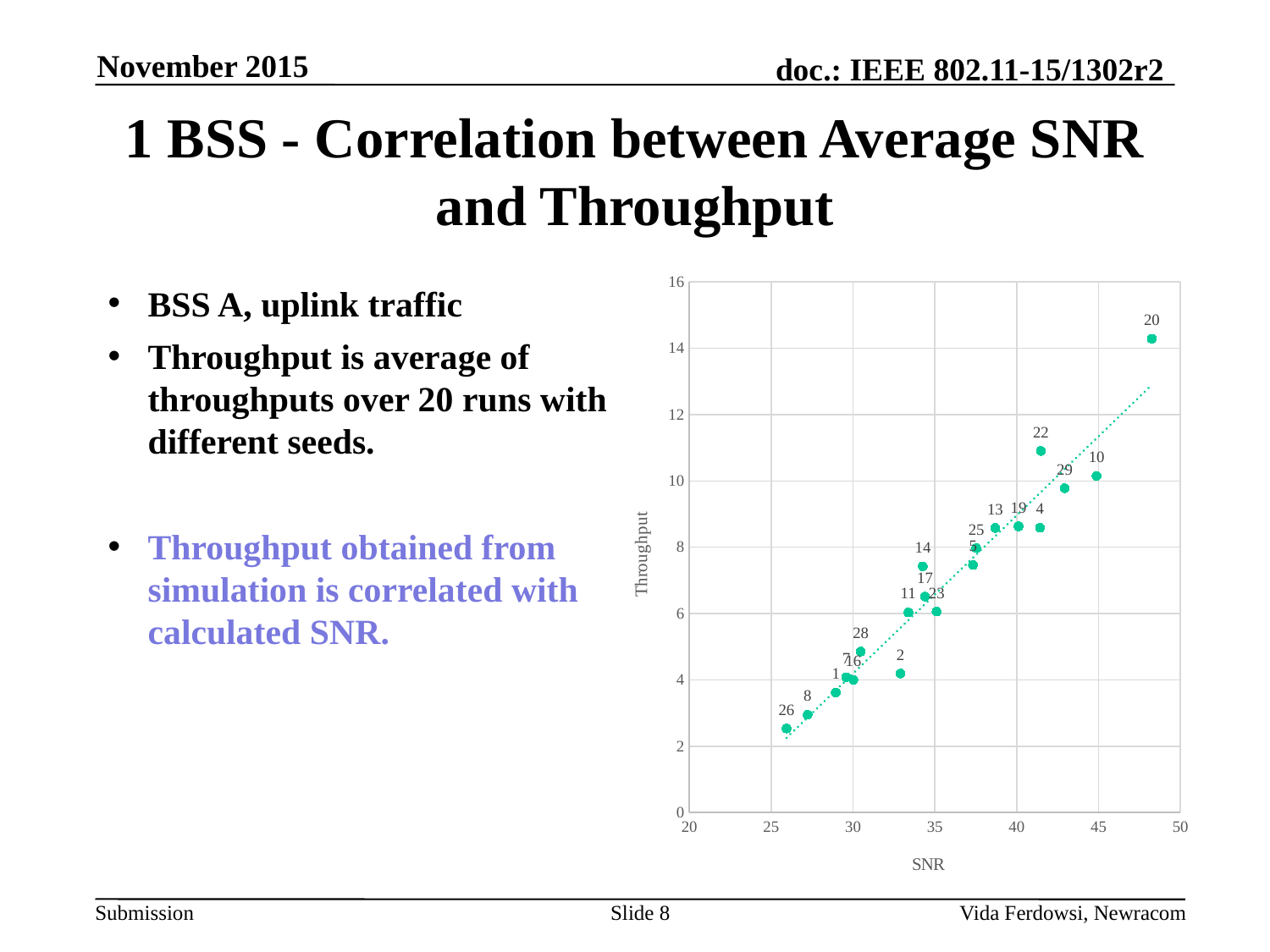
Is the SNR for point 10 greater or less than 40? greater Is the throughput for point 20 greater or less than 12? greater Which labelled point has the highest SNR? 20 What is the title of the x axis of the chart? SNR What is the title of the y axis of the chart? Throughput What kind of chart is shown on the slide? scatter chart Is the throughput for point 22 greater or less than 10? greater Which labelled point has the highest throughput? 20 Which has the higher throughput, point 20 or point 22? point 20 Which labelled point has the lowest throughput? 26 Does throughput generally rise or fall as SNR increases along the x axis? rise